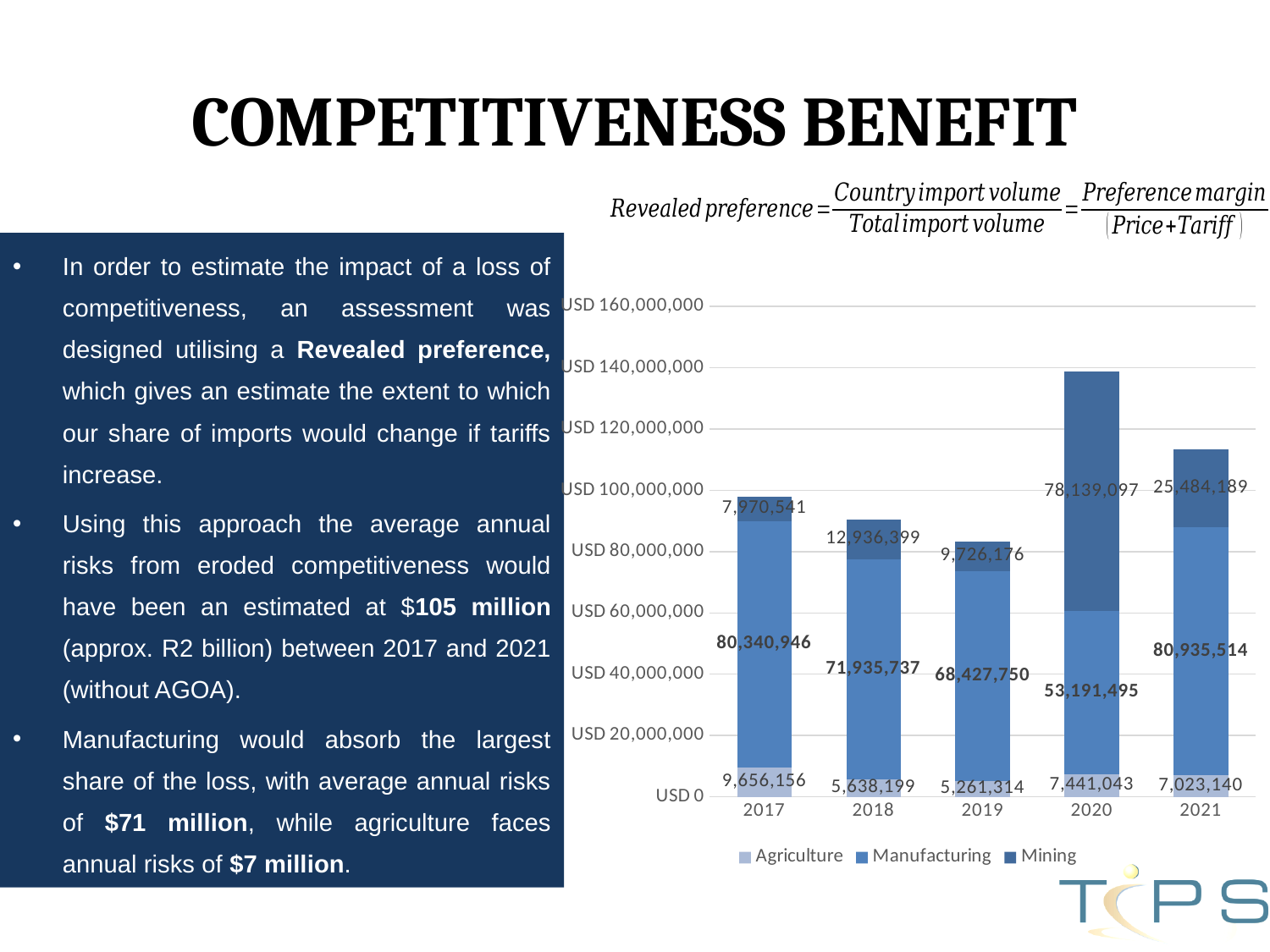
In which year is the Mining value highest? 2020 Which is larger, the Mining value for 2018 or the Mining value for 2019? 2018 What is the difference between the Manufacturing values for 2021 and 2017? 594,568 What kind of chart is shown on the slide? Stacked bar chart What is the Manufacturing value for 2017? 80,340,946 In which year is the Agriculture value lowest? 2019 What is the total of the stacked bar for 2017? 97,967,643 How many series does the legend list? 3 What is the Agriculture value for 2018? 5,638,199 How many years are shown on the x axis? 5 Is the total height of the 2020 stacked bar greater or less than USD 120,000,000? greater What is the Mining value for 2020? 78,139,097